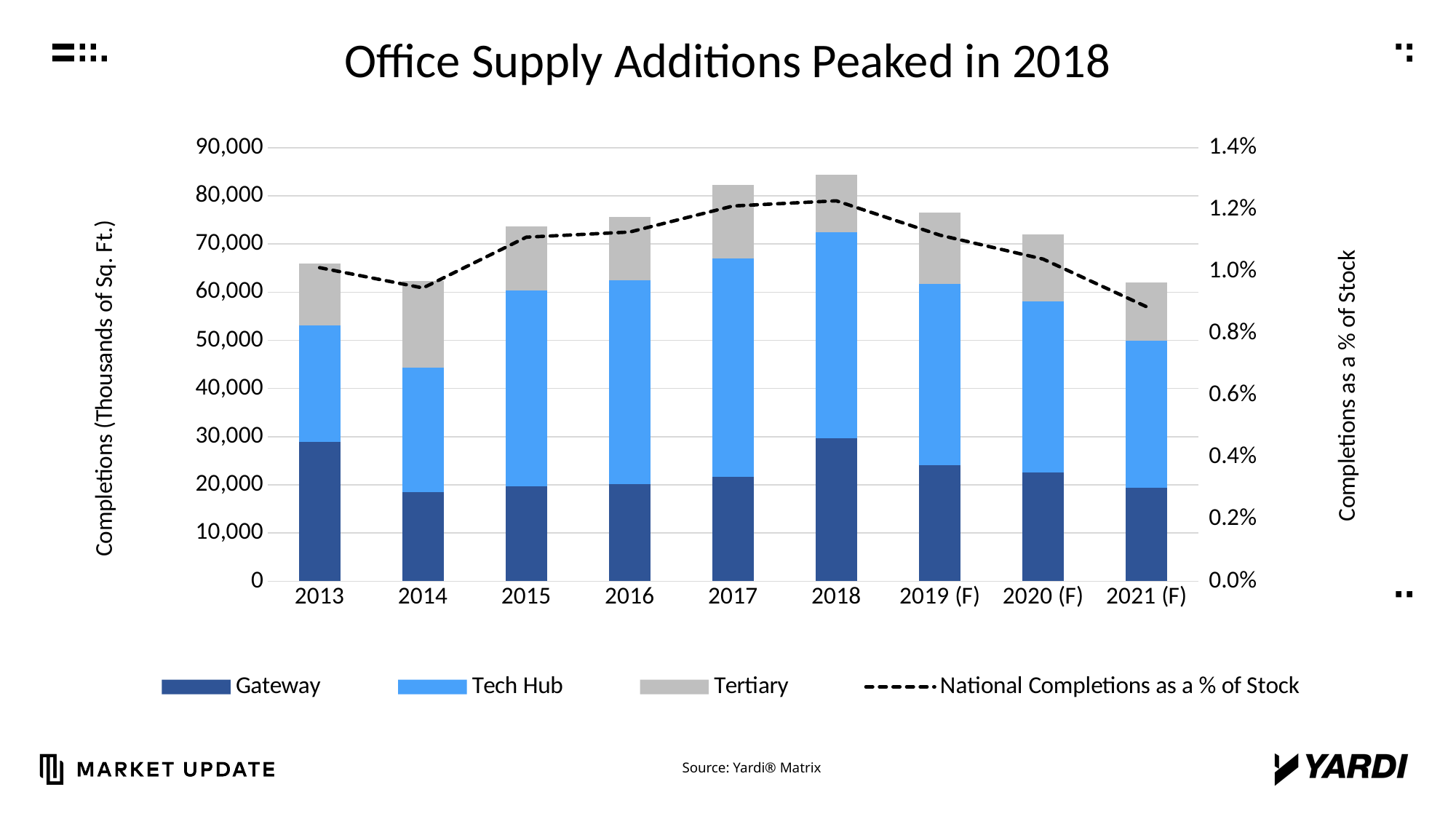
Is the National Completions as a % of Stock value for 2021 (F) greater or less than 1.0%? less Is the total completions bar for 2018 greater or less than 80,000? greater Which year has a larger total completions bar, 2016 or 2017? 2017 How many years are shown on the x axis? 9 Is the Gateway value for 2013 greater or less than 20,000? greater Does the National Completions as a % of Stock line rise or fall from 2018 to 2021 (F)? fall What kind of chart is this? Stacked bar chart with a line Which year has a larger total completions bar, 2014 or 2015? 2015 Is the National Completions as a % of Stock value higher in 2018 or in 2021 (F)? 2018 How many series does the legend list? 4 Which year has the tallest stacked bar for total completions? 2018